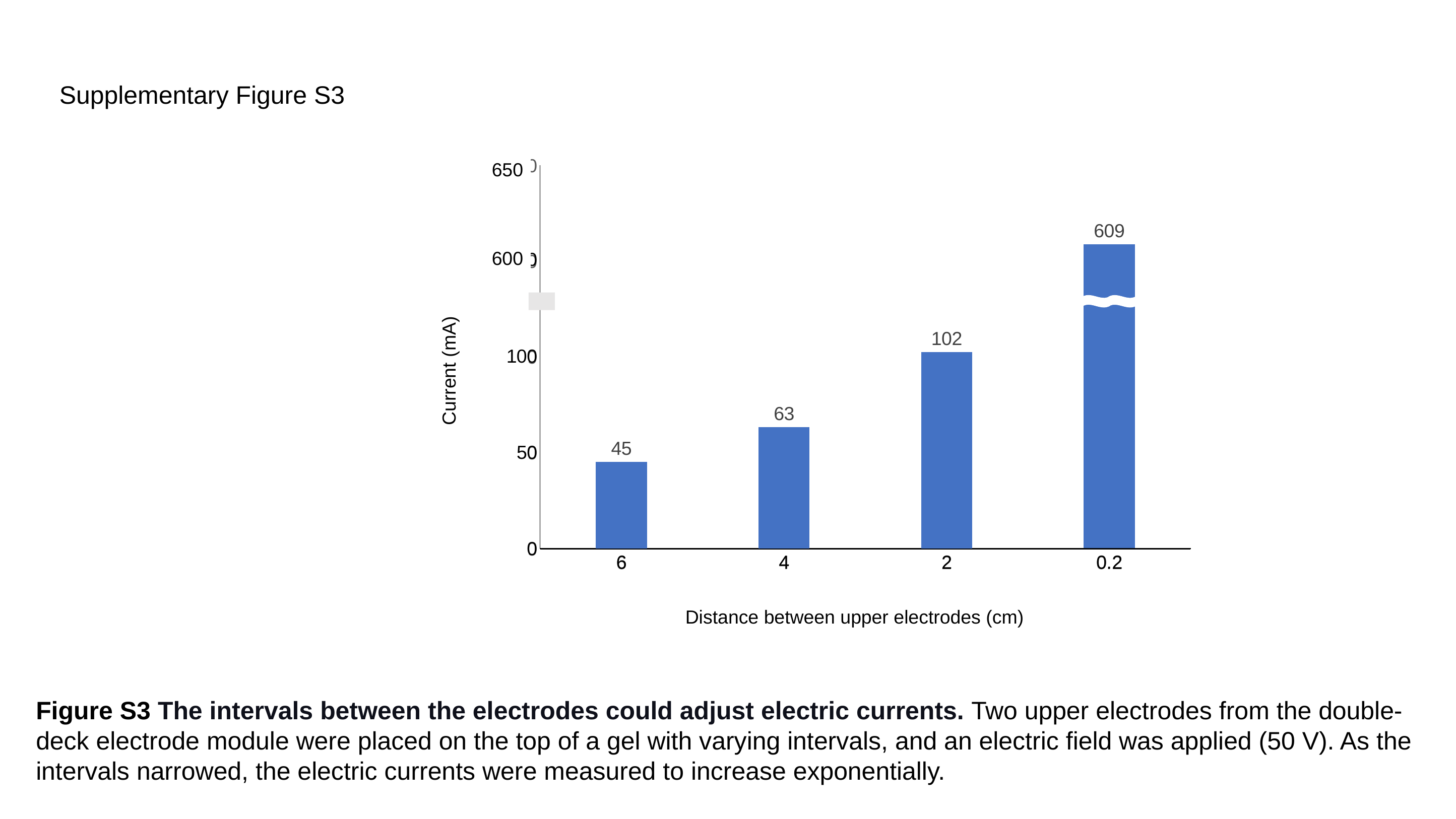
Does the current rise or fall as you move from left to right along the x axis? Rise Which distance between upper electrodes gives the lowest current? 6 What is the current (mA) when the distance between upper electrodes is 0.2 cm? 609 How many distance categories are plotted on the chart? 4 What is the difference in current between the 4 cm and 6 cm distances? 18 What is the current (mA) when the distance between upper electrodes is 6 cm? 45 What kind of chart is shown on the slide? Bar chart What is the current (mA) when the distance between upper electrodes is 4 cm? 63 Which distance between upper electrodes gives the highest current? 0.2 What is the difference in current between the 0.2 cm and 2 cm distances? 507 What is the current (mA) when the distance between upper electrodes is 2 cm? 102 Which has a larger current, the 2 cm distance or the 4 cm distance? 2 cm